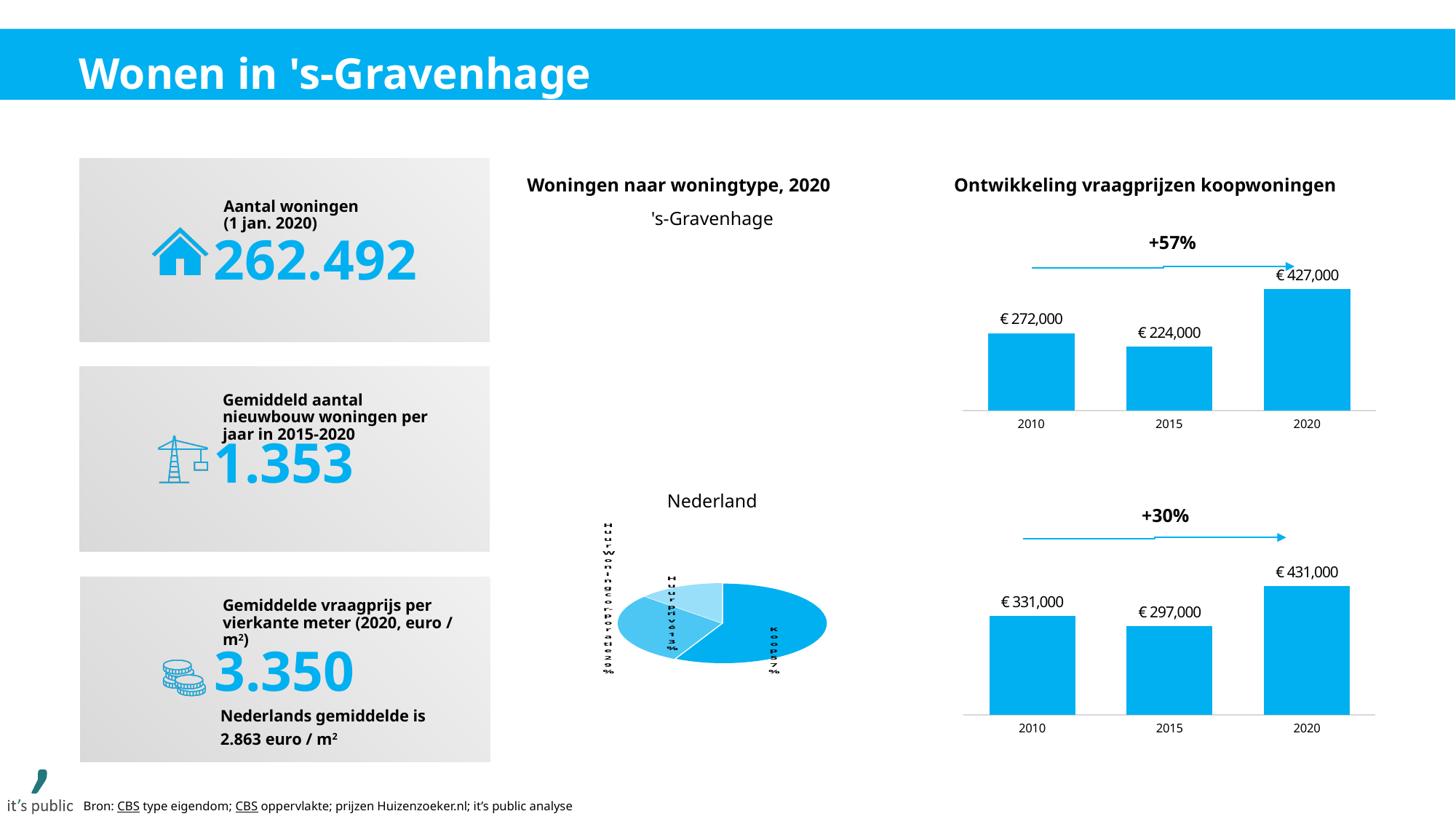
In the upper bar chart under 'Ontwikkeling vraagprijzen koopwoningen', what is the difference between the 2020 and 2010 values? € 155,000 What kind of chart is used under 'Ontwikkeling vraagprijzen koopwoningen'? Bar chart In the lower bar chart under 'Ontwikkeling vraagprijzen koopwoningen', which year has the lowest value? 2015 How many bars are in the upper bar chart under 'Ontwikkeling vraagprijzen koopwoningen'? 3 In the lower bar chart under 'Ontwikkeling vraagprijzen koopwoningen', what is the difference between the 2010 and 2015 values? € 34,000 In the upper bar chart under 'Ontwikkeling vraagprijzen koopwoningen', what is the value for 2015? € 224,000 In the upper bar chart under 'Ontwikkeling vraagprijzen koopwoningen', what is the value for 2020? € 427,000 In the upper bar chart under 'Ontwikkeling vraagprijzen koopwoningen', which year has the highest value? 2020 In the lower bar chart under 'Ontwikkeling vraagprijzen koopwoningen', is the value for 2010 or 2020 larger? 2020 In the 'Nederland' pie chart under 'Woningen naar woningtype, 2020', what share is labelled for Koop? 57% In the lower bar chart under 'Ontwikkeling vraagprijzen koopwoningen', what is the value for 2010? € 331,000 What percentage change is shown above the upper bar chart under 'Ontwikkeling vraagprijzen koopwoningen'? +57%